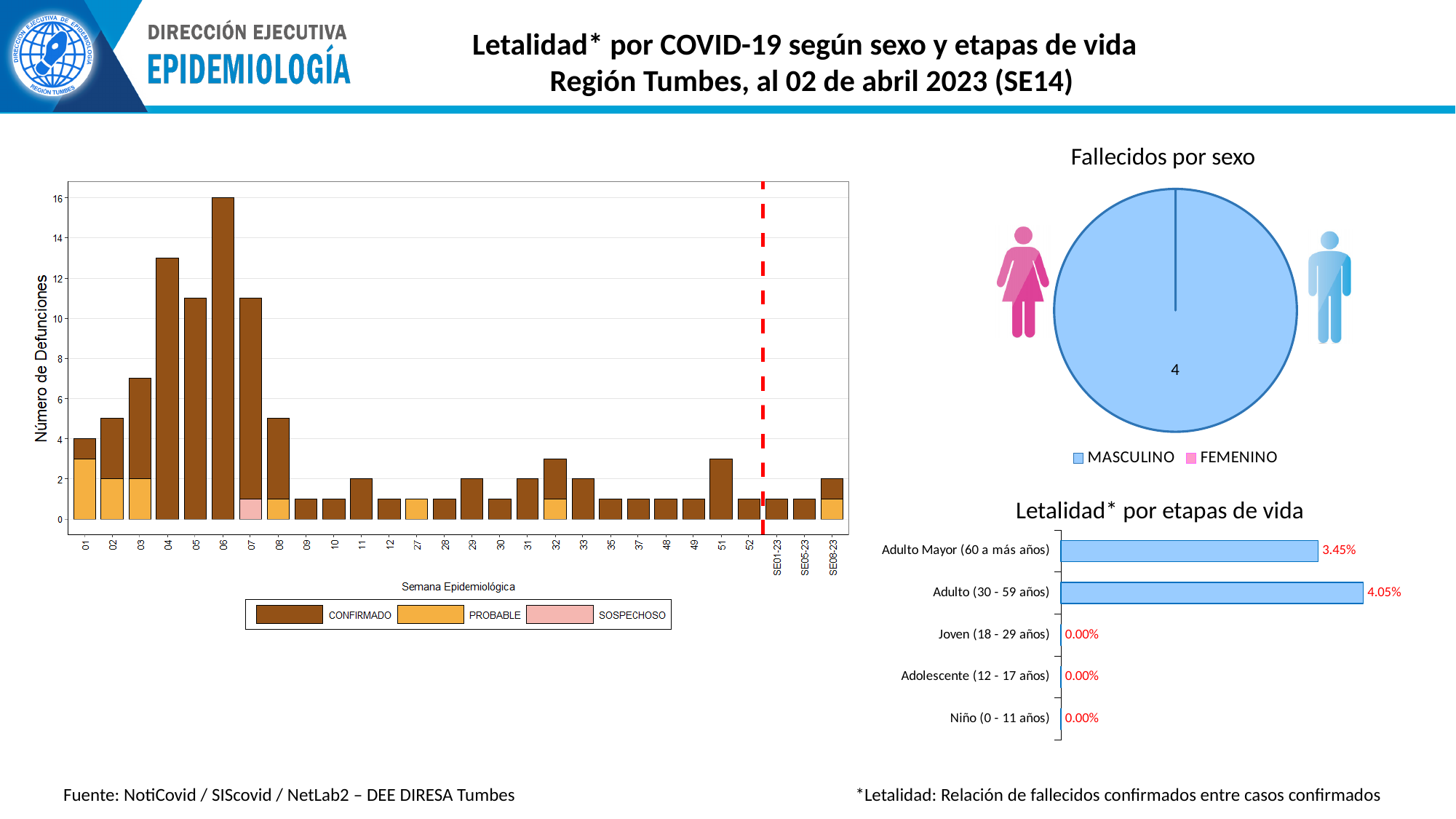
In the 'Letalidad* por etapas de vida' chart, what is the difference between the values for Adulto (30 - 59 años) and Adulto Mayor (60 a más años)? 0.60% In the 'Letalidad* por etapas de vida' chart, what is the value for Adulto Mayor (60 a más años)? 3.45% What kind of chart is the 'Letalidad* por etapas de vida' chart? bar chart In the left chart of deaths by epidemiological week, is the value for week 04 greater or less than 12? greater In the 'Fallecidos por sexo' pie chart, which sex has the larger share? MASCULINO In the left chart of deaths by epidemiological week, how many series does the legend list? 3 In the left chart of deaths by epidemiological week, which week has the highest number of deaths? 06 In the 'Letalidad* por etapas de vida' chart, which age group has the highest lethality? Adulto (30 - 59 años) In the 'Fallecidos por sexo' pie chart, what value is shown for MASCULINO? 4 In the 'Letalidad* por etapas de vida' chart, what is the value for Adulto (30 - 59 años)? 4.05% In the 'Letalidad* por etapas de vida' chart, what is the value for Joven (18 - 29 años)? 0.00% In the 'Letalidad* por etapas de vida' chart, how many age groups are shown? 5